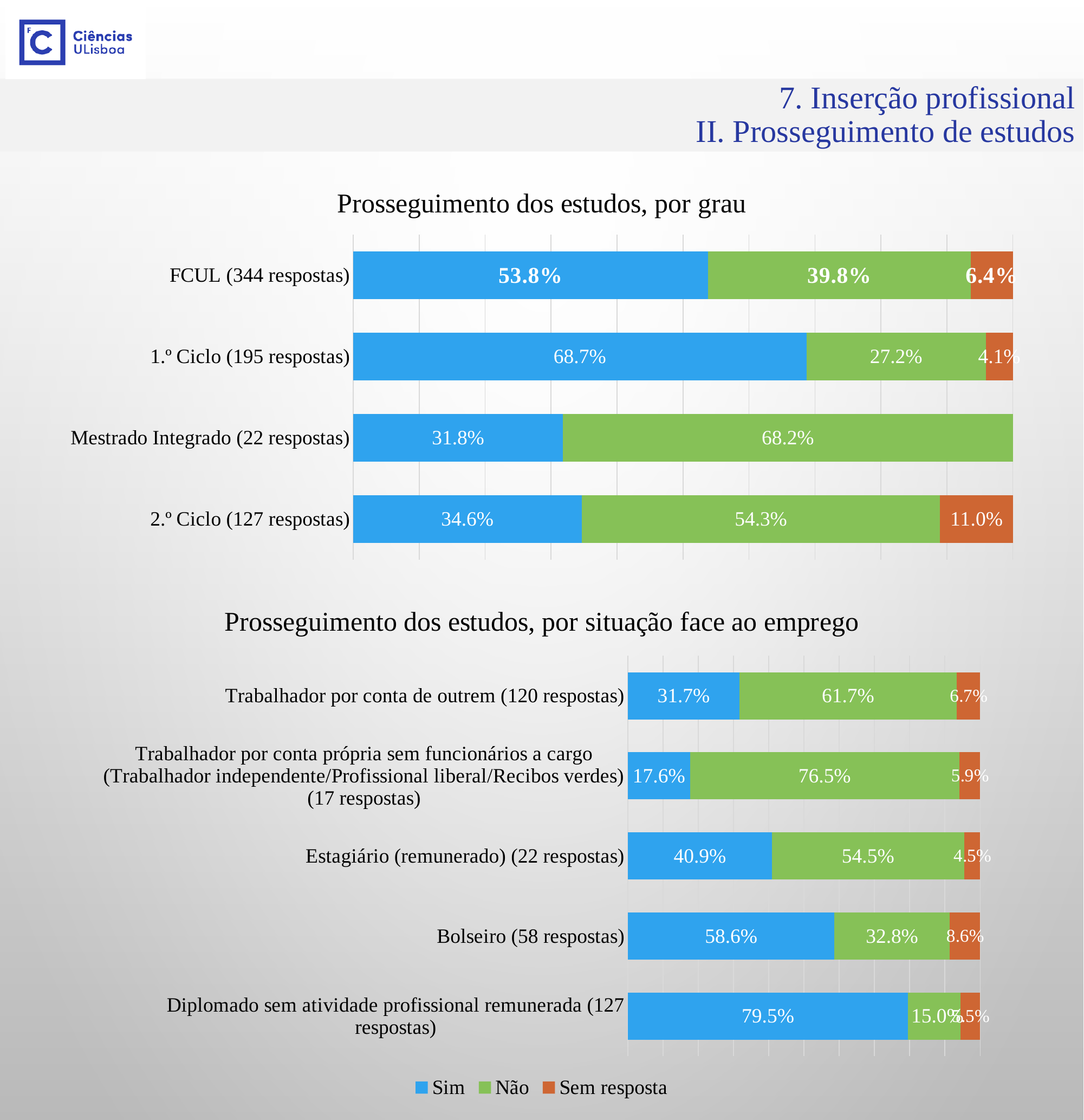
In the chart 'Prosseguimento dos estudos, por grau', what is the 'Não' value for Mestrado Integrado (22 respostas)? 68.2% In the chart 'Prosseguimento dos estudos, por situação face ao emprego', what is the 'Sim' value for Bolseiro (58 respostas)? 58.6% In the chart 'Prosseguimento dos estudos, por situação face ao emprego', what is the 'Não' value for Trabalhador por conta própria sem funcionários a cargo (17 respostas)? 76.5% In the chart 'Prosseguimento dos estudos, por grau', what is the 'Sim' value for 1.º Ciclo (195 respostas)? 68.7% In the chart 'Prosseguimento dos estudos, por situação face ao emprego', how many categories are shown? 5 In the chart 'Prosseguimento dos estudos, por grau', how many categories are shown? 4 In the chart 'Prosseguimento dos estudos, por grau', what is the difference between the 'Sim' and 'Não' values for FCUL (344 respostas)? 14.0% In the chart 'Prosseguimento dos estudos, por situação face ao emprego', which is larger: the 'Sim' value for Estagiário (remunerado) or the 'Sim' value for Trabalhador por conta de outrem? Estagiário (remunerado) In the chart 'Prosseguimento dos estudos, por grau', which category has the highest 'Sim' value? 1.º Ciclo (195 respostas) How many series does the legend at the bottom of the slide list? 3 In the chart 'Prosseguimento dos estudos, por situação face ao emprego', which category has the highest 'Sim' value? Diplomado sem atividade profissional remunerada (127 respostas) In the chart 'Prosseguimento dos estudos, por grau', what is the 'Sem resposta' value for 2.º Ciclo (127 respostas)? 11.0%